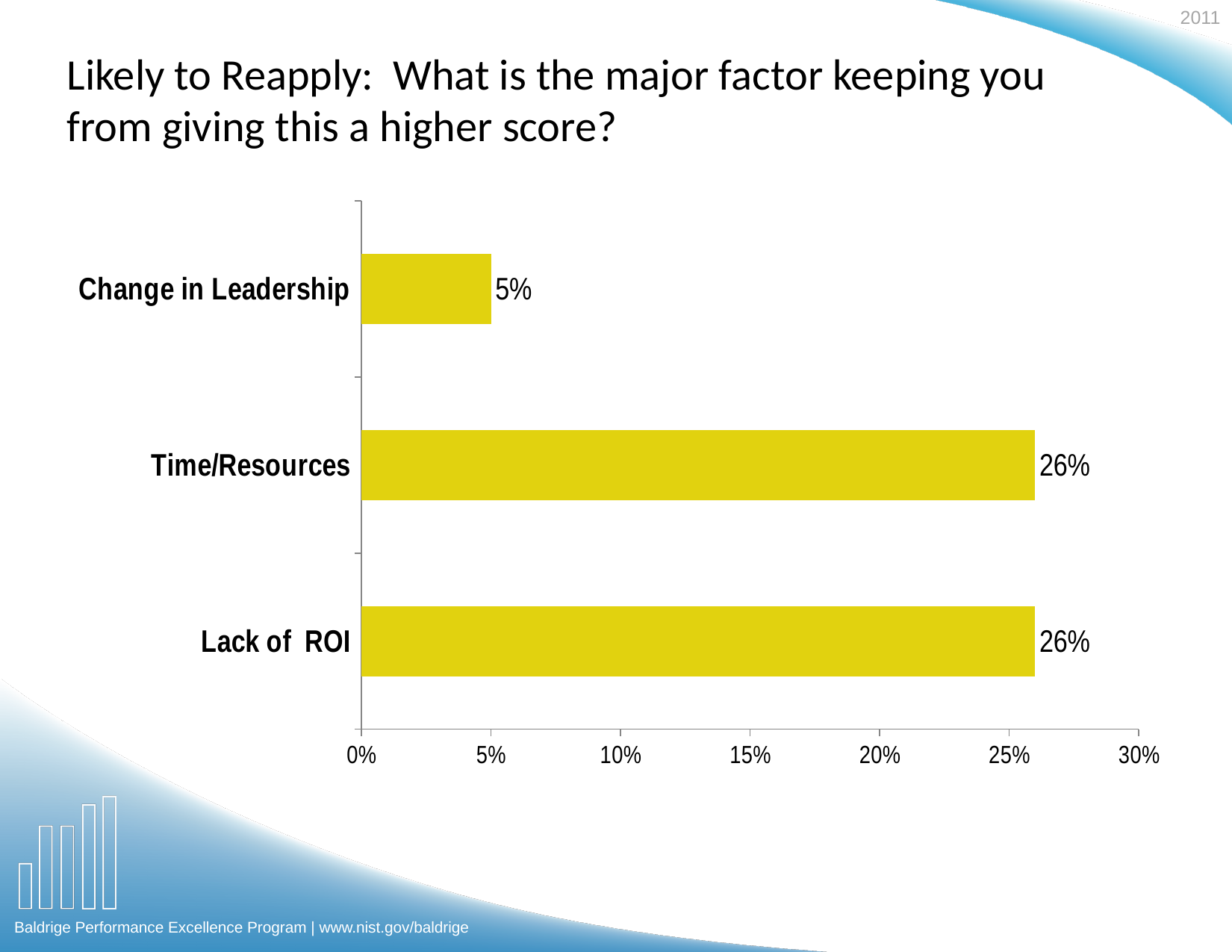
Which is larger, the value for Lack of ROI or the value for Change in Leadership? Lack of ROI Is the value for Change in Leadership greater or less than 10%? less What is the value for Change in Leadership? 5% What is the value for Lack of ROI? 26% What colour are the bars in the chart? Yellow What is the difference between the values for Time/Resources and Change in Leadership? 21% What kind of chart is shown on the slide? Bar chart What is the maximum value shown on the horizontal axis? 30% Which category has the lowest value? Change in Leadership Is the value for Time/Resources greater or less than 20%? greater How many categories are shown in the chart? 3 What is the value for Time/Resources? 26%